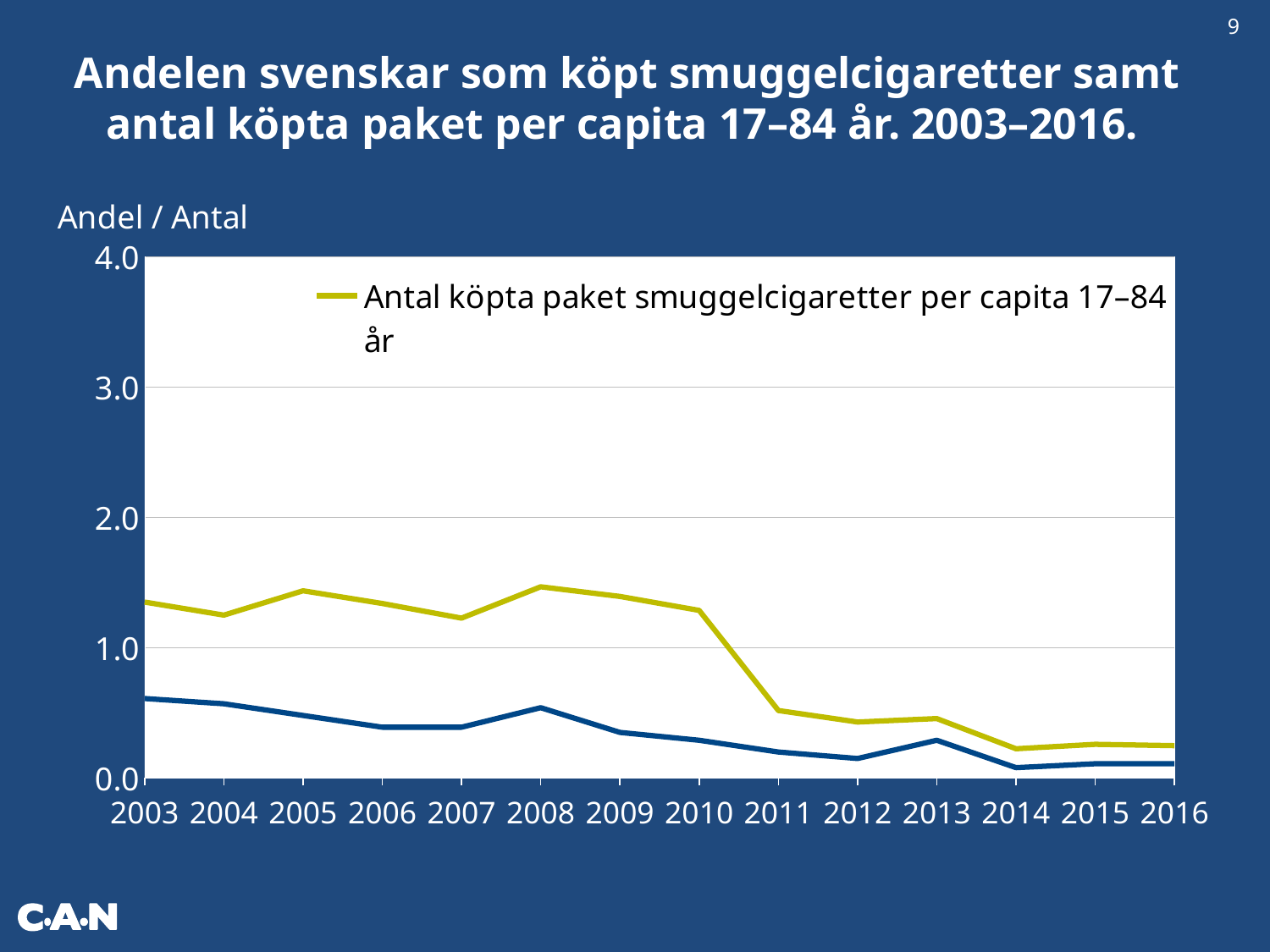
What kind of chart is shown on the slide? line chart Is the value for 'Antal köpta paket smuggelcigaretter per capita 17–84 år' in 2011 greater or less than 1.0? less Overall, does the 'Antal köpta paket smuggelcigaretter per capita 17–84 år' line rise or fall from 2003 to 2016? fall How many years are shown on the x axis of the chart? 14 What is the first year shown on the x axis of the chart? 2003 Is the value of the blue line in 2003 greater or less than 1.0? less Is the value for 'Antal köpta paket smuggelcigaretter per capita 17–84 år' in 2010 greater or less than 1.0? greater Which is larger for 'Antal köpta paket smuggelcigaretter per capita 17–84 år': the value in 2010 or the value in 2011? 2010 What is the label shown above the y axis of the chart? Andel / Antal How many series does the chart's legend list? 1